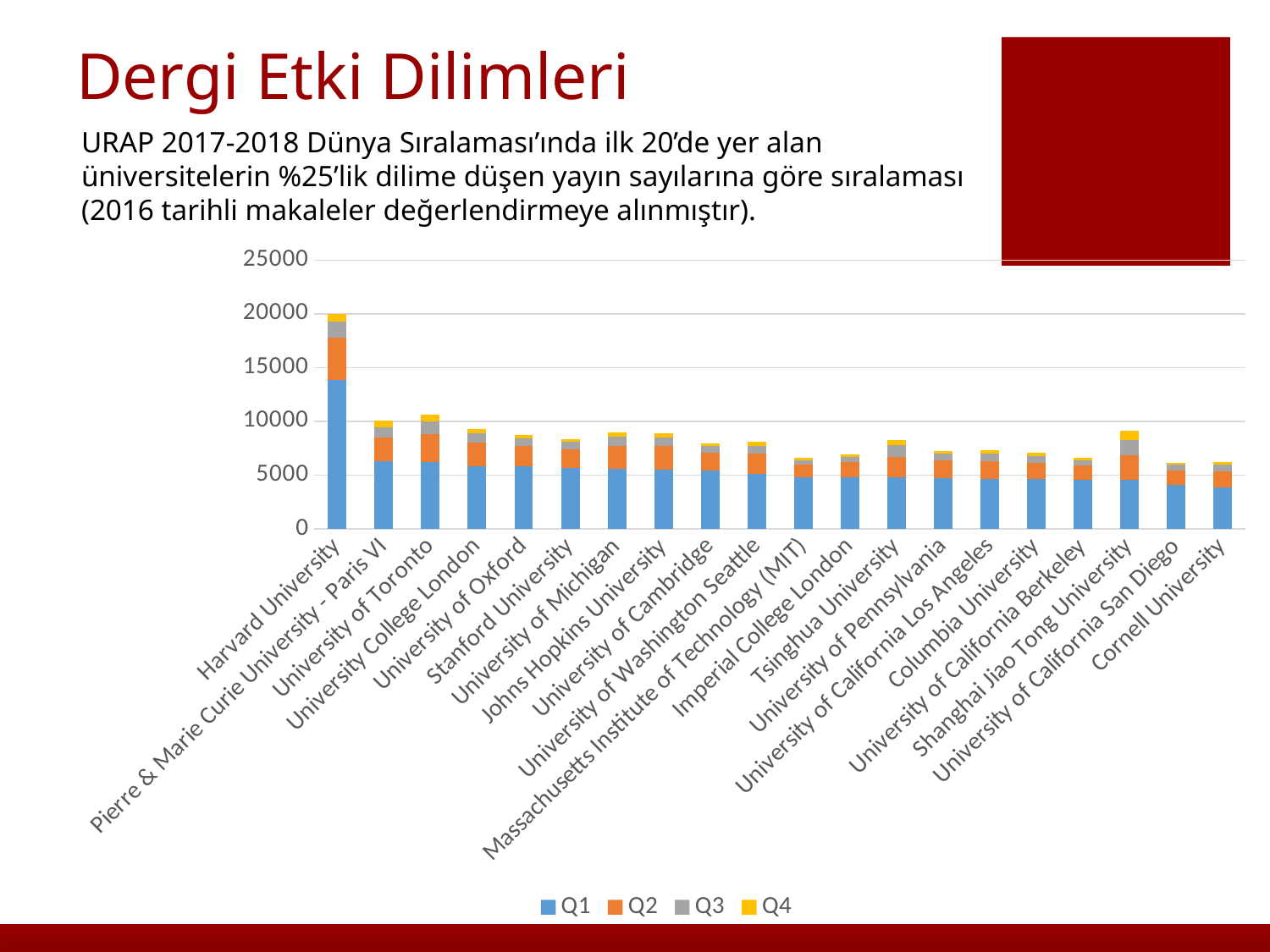
Which has the larger total bar, Shanghai Jiao Tong University or University of California San Diego? Shanghai Jiao Tong University Do the total bar heights generally rise or fall from left to right along the x axis? fall Is the total bar for Cornell University greater or less than 5000? greater What are the entries listed in the chart legend? Q1, Q2, Q3, Q4 Is the total bar for Stanford University greater or less than 10000? less Is the Q1 value for Cornell University greater or less than 5000? less Which has the larger total bar, Harvard University or University of Toronto? Harvard University How many series does the chart legend list? 4 Which university has the highest total bar in the chart? Harvard University How many universities are shown on the x axis of the chart? 20 What kind of chart is shown on the slide? Stacked bar chart